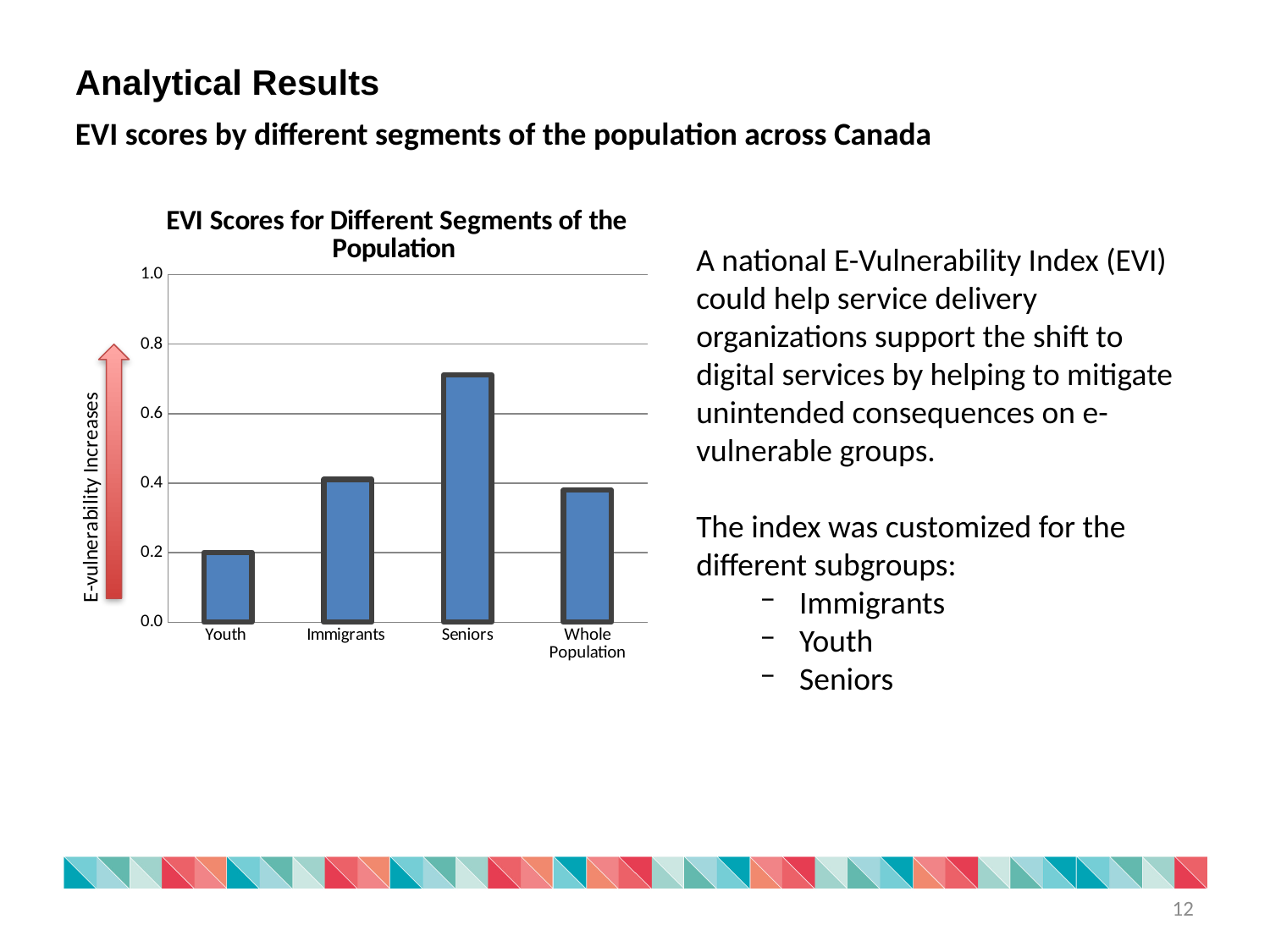
Which has a higher EVI score, Youth or Whole Population? Whole Population What label appears along the vertical axis of the chart? E-vulnerability Increases Is the EVI score for Immigrants greater or less than 0.6? less How many population segments are plotted in the chart? 4 What is the title of the chart? EVI Scores for Different Segments of the Population Which has a higher EVI score, Seniors or Immigrants? Seniors Which population segment has the highest EVI score? Seniors Is the EVI score for Seniors greater or less than 0.6? greater Is the EVI score for Whole Population greater or less than 0.2? greater What kind of chart is shown on the slide? bar chart Which population segment has the lowest EVI score? Youth